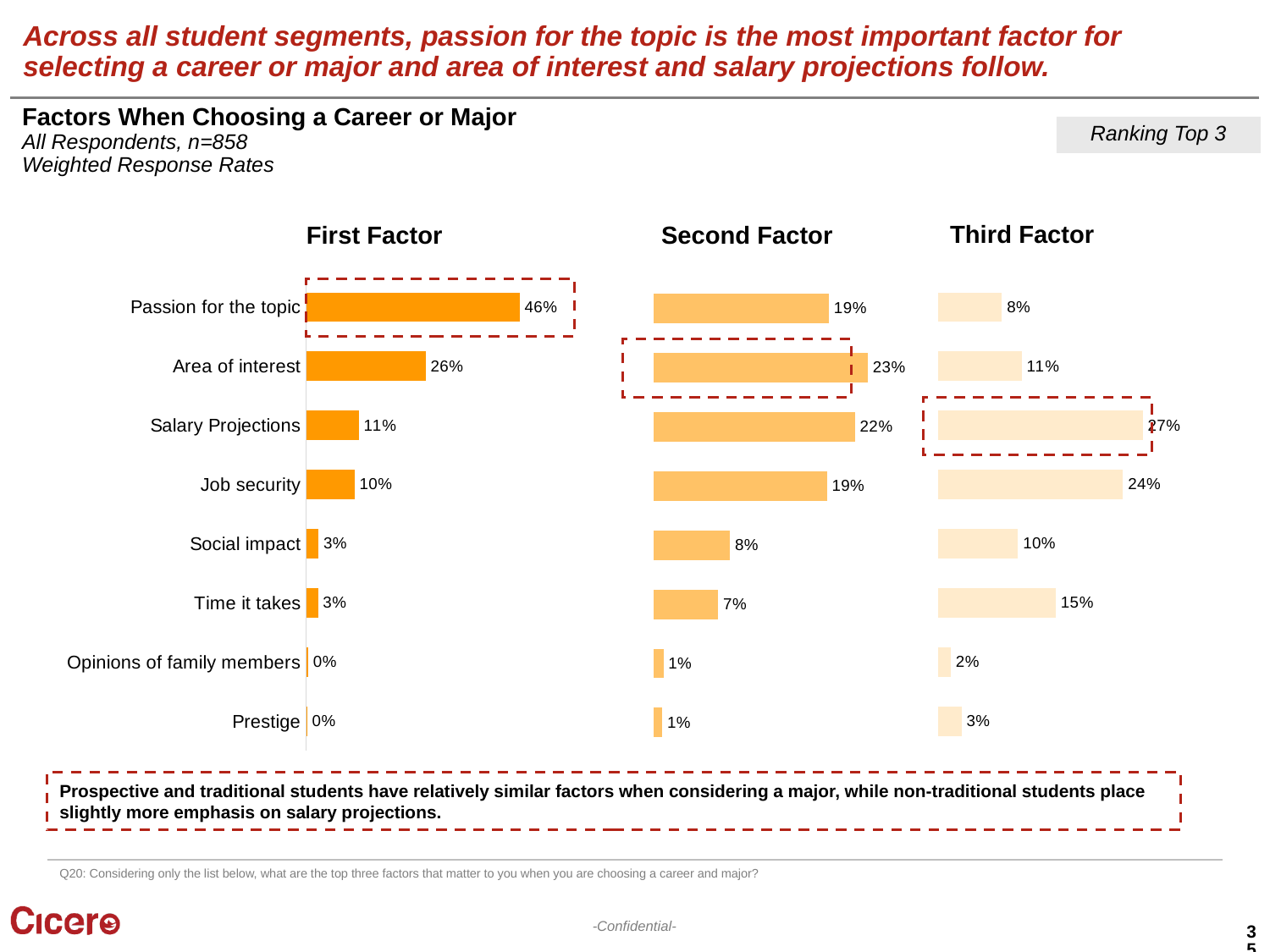
In the First Factor chart, what is the value for Prestige? 0% In the Second Factor chart, what is the value for Area of interest? 23% In the Third Factor chart, which category has the highest value? Salary Projections In the Third Factor chart, which is larger, Time it takes or Social impact? Time it takes What is the title of the chart section on the slide? Factors When Choosing a Career or Major In the First Factor chart, what is the value for Passion for the topic? 46% In the First Factor chart, what is the difference between Passion for the topic and Area of interest? 20% What kind of chart is the Second Factor chart? Bar chart In the Second Factor chart, which category has the lowest value, Social impact or Time it takes? Time it takes In the Second Factor chart, what is the difference between Salary Projections and Social impact? 14% How many categories does the First Factor chart show? 8 In the Third Factor chart, what is the value for Job security? 24%